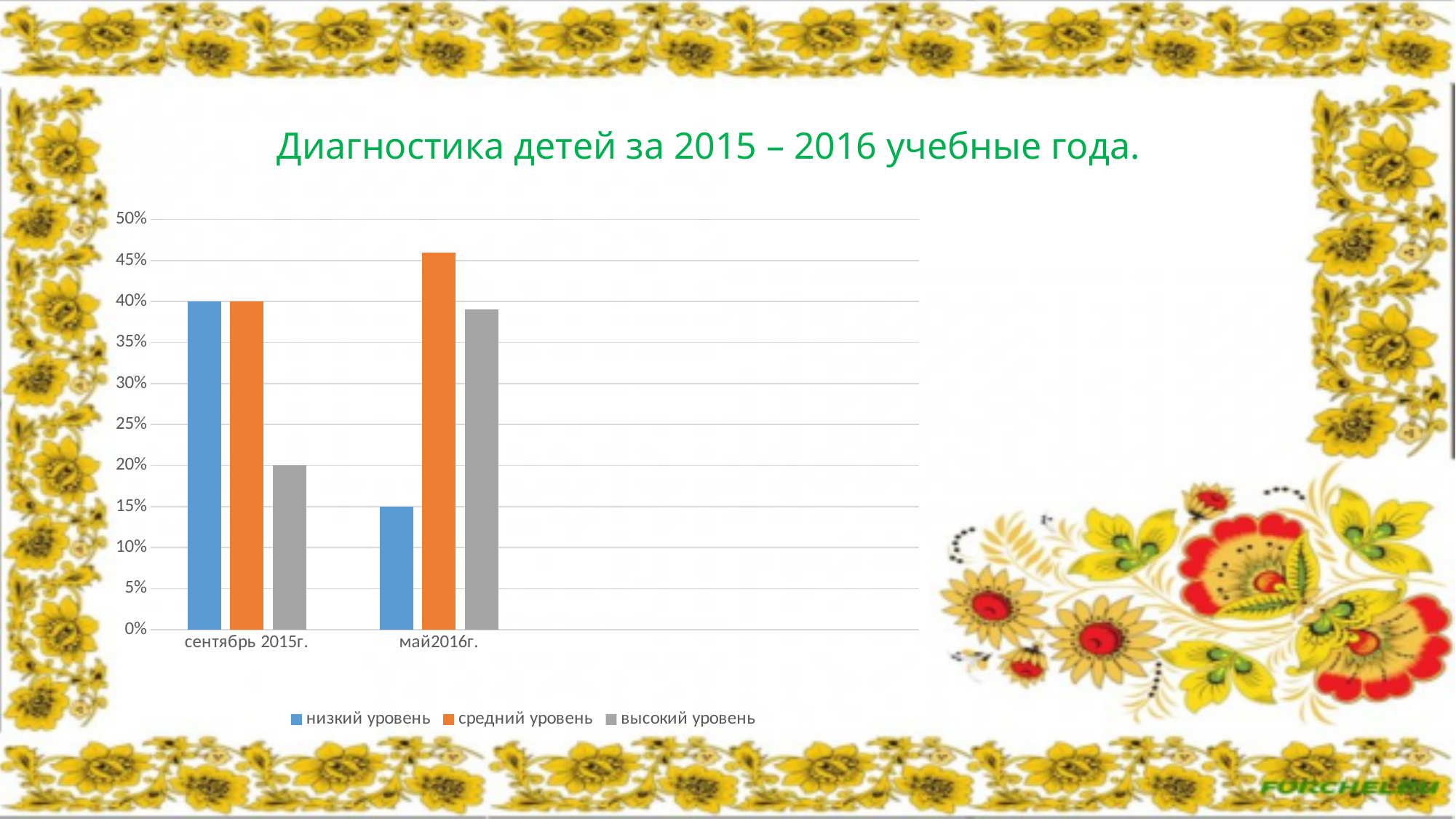
How many categories are shown on the x axis of the chart? 2 Is the value for высокий уровень in май2016г. greater or less than 40%? less Does the value for низкий уровень rise or fall from сентябрь 2015г. to май2016г.? fall Which series has the lowest value in сентябрь 2015г.? высокий уровень What is the title of the chart? Диагностика детей за 2015 – 2016 учебные года. Which series has the highest value in май2016г.? средний уровень What is the value for низкий уровень in сентябрь 2015г.? 40% Is the value for средний уровень in май2016г. greater or less than 45%? greater What kind of chart is shown on the slide? bar chart What is the value for высокий уровень in сентябрь 2015г.? 20% What is the value for низкий уровень in май2016г.? 15% How many series does the chart legend list? 3